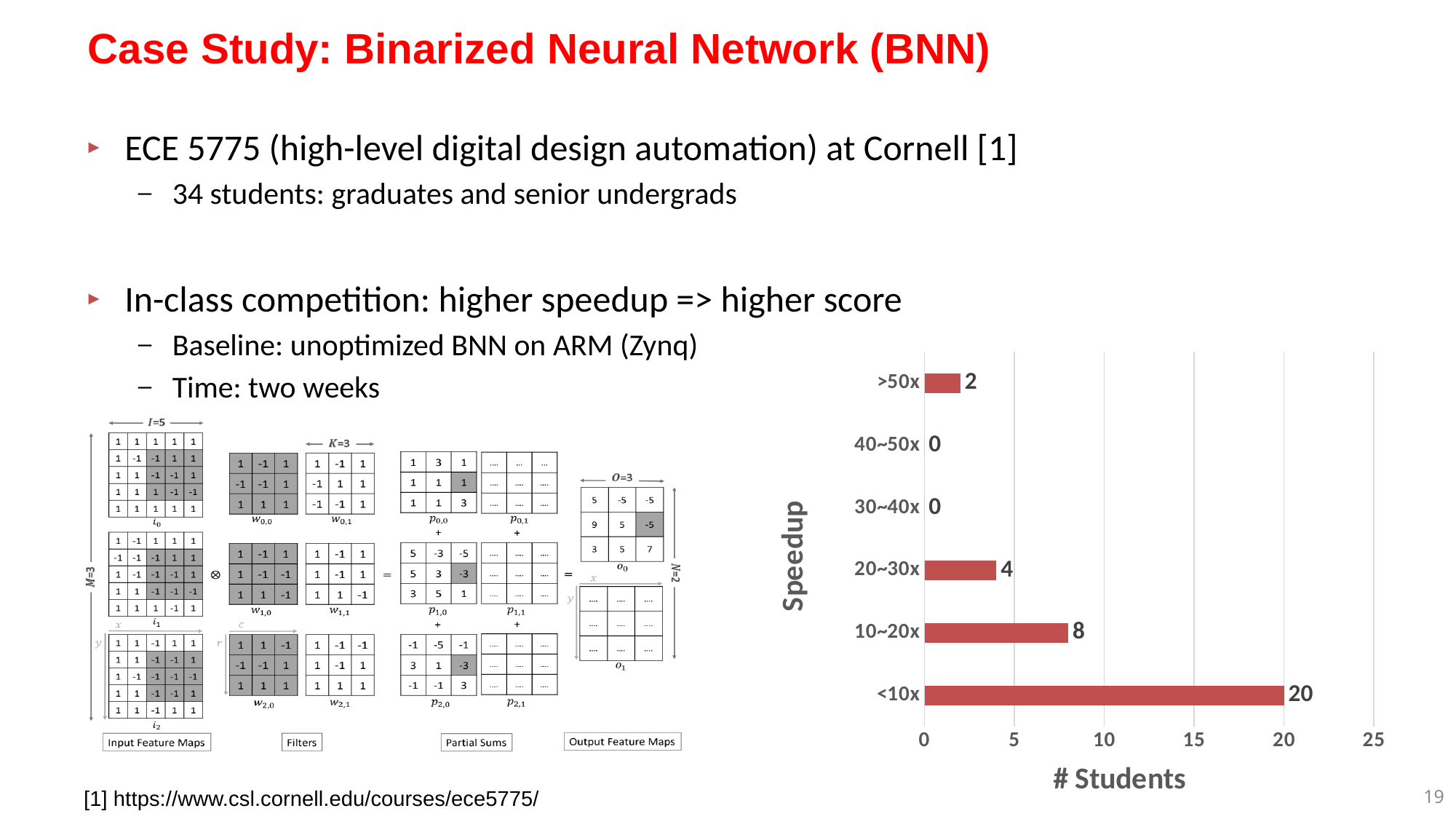
How many students achieved a speedup of <10x? 20 What is the label of the x axis of the chart? # Students What is the difference in number of students between the <10x and 10~20x speedup categories? 12 How many students are in the 30~40x and 40~50x speedup categories combined? 0 What is the label of the y axis of the chart? Speedup How many students achieved a speedup of >50x? 2 How many students achieved a speedup of 10~20x? 8 Which speedup category has the most students? <10x How many students achieved a speedup of 20~30x? 4 Which has more students, the 20~30x category or the >50x category? 20~30x How many speedup categories are shown on the y axis of the chart? 6 What kind of chart is shown on the slide? bar chart